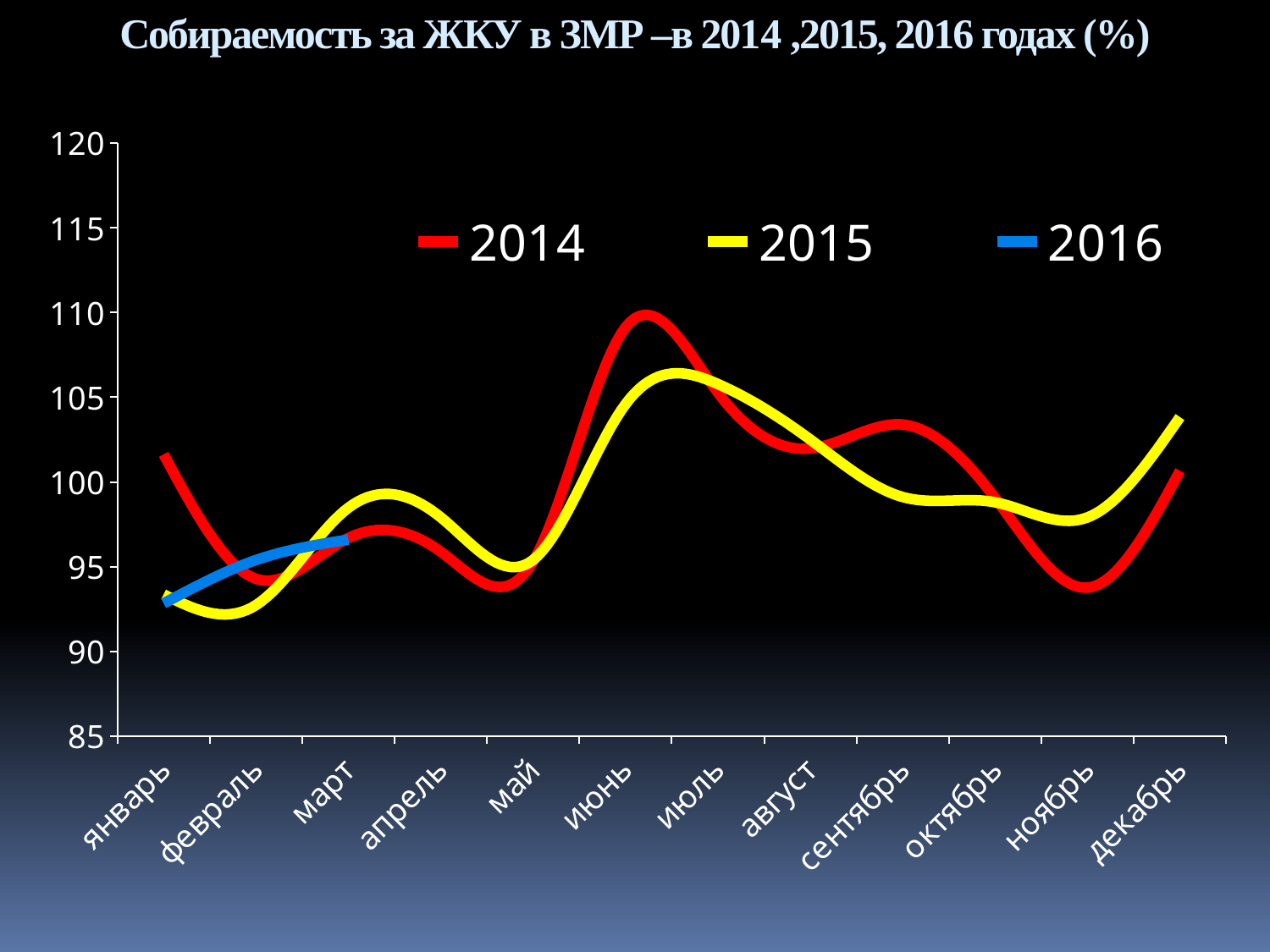
In which month does the 2015 series reach its lowest value? февраль In январь, which series has the larger value, 2014 or 2015? 2014 Is the value for 2014 in июнь greater or less than 105? greater What kind of chart is shown on the slide? line chart In which month does the 2014 series reach its highest value? июнь What colour is the line for the 2016 series? blue How many series does the legend list? 3 How many months are shown along the x axis? 12 Does the 2016 series rise or fall from январь to март? rises Is the value for 2014 in ноябрь greater or less than 95? less Is the value for 2015 in февраль greater or less than 95? less In декабрь, which series has the larger value, 2014 or 2015? 2015